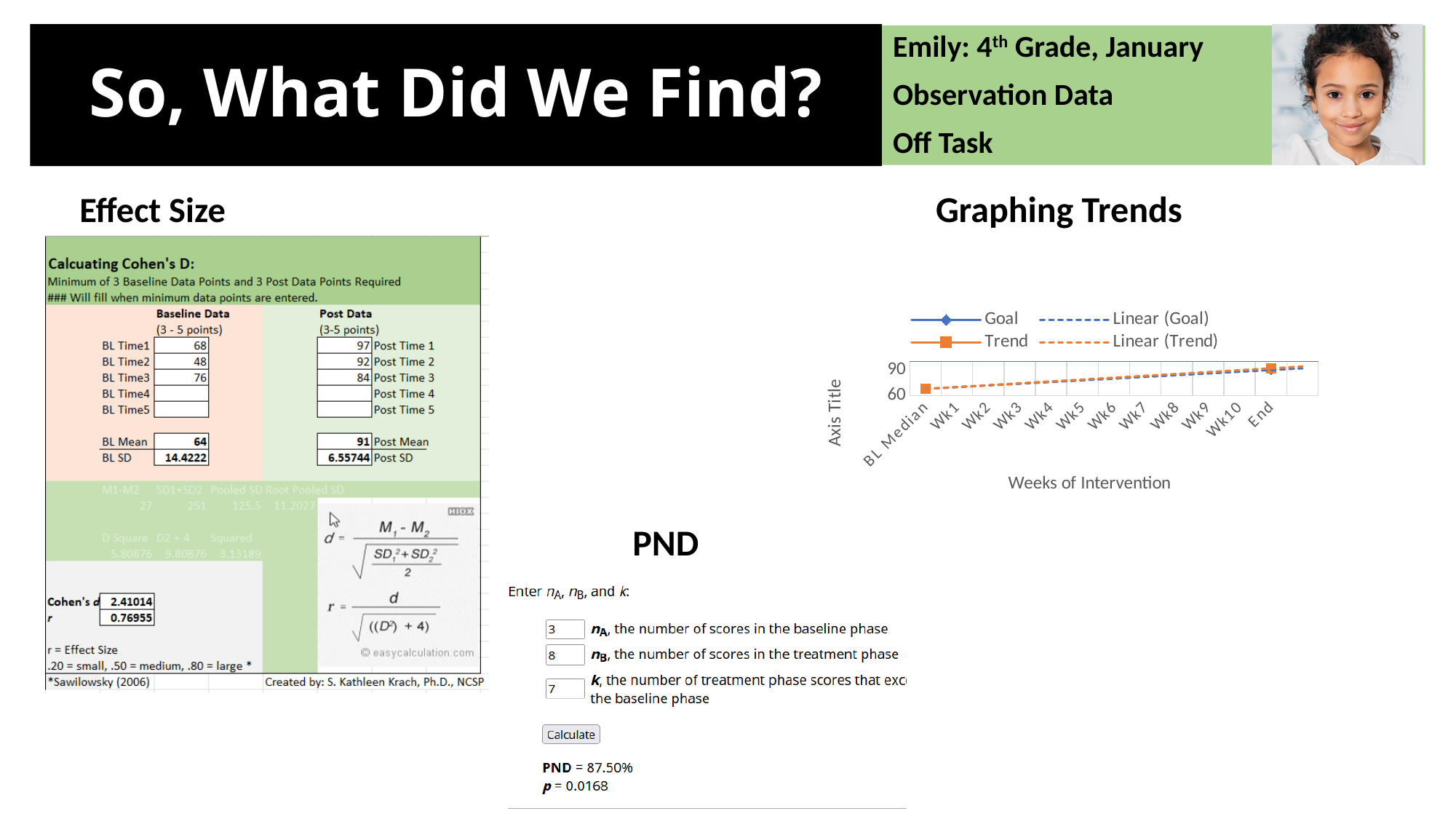
In the Graphing Trends chart, is the Trend value at BL Median greater or less than 90? less What kind of chart is shown under the heading "Graphing Trends"? line chart What is the x-axis title of the Graphing Trends chart? Weeks of Intervention How many entries does the legend of the Graphing Trends chart list? 4 In the Graphing Trends chart, how many categories are labelled along the x axis? 12 In the Graphing Trends chart, which is larger: the Trend value at BL Median or the Trend value at End? End In the Graphing Trends chart, does the Trend line rise or fall from BL Median to End? rise What is the first category on the x axis of the Graphing Trends chart? BL Median In the Graphing Trends chart, is the Trend value at End greater or less than 60? greater